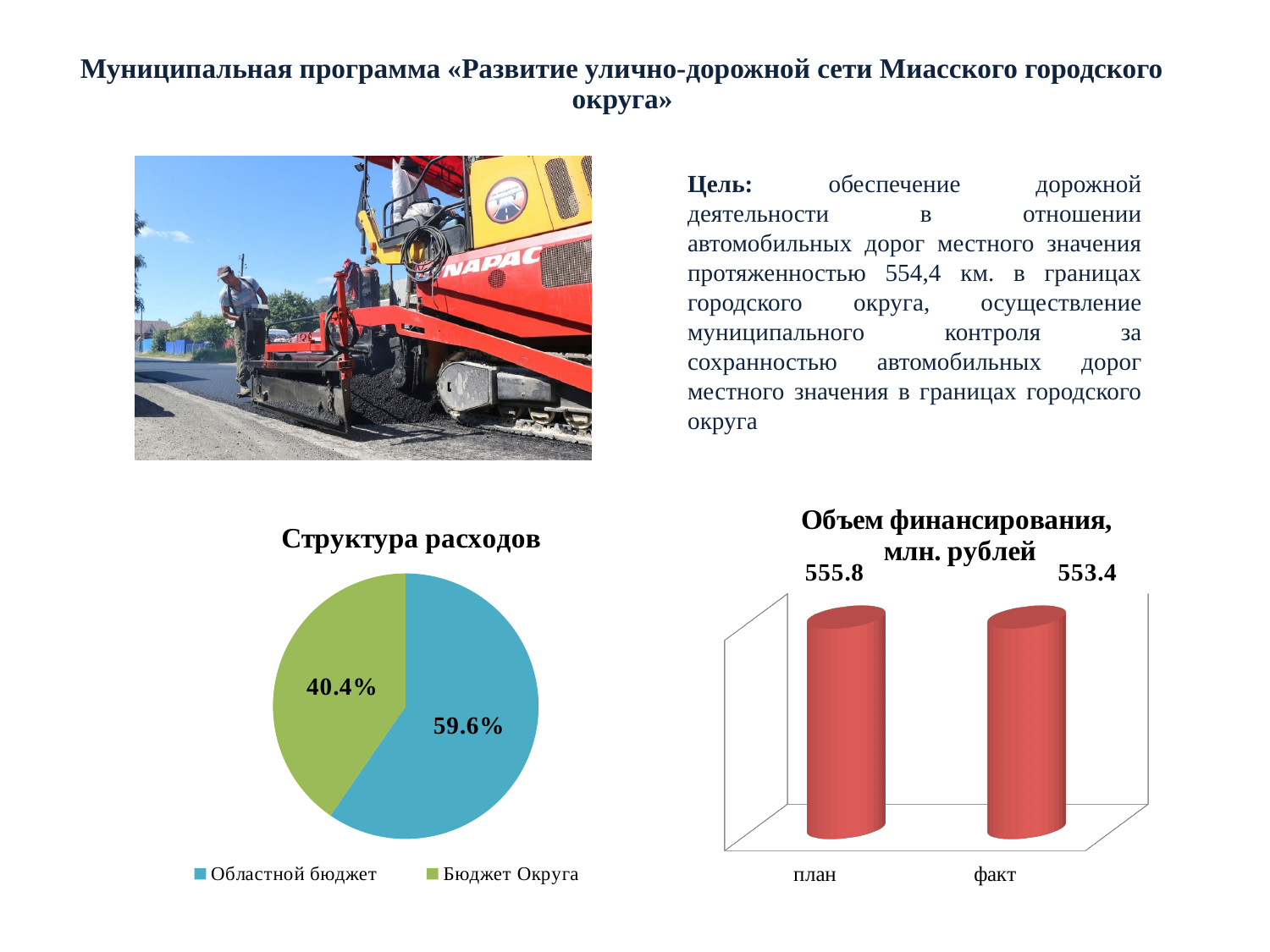
In the chart titled «Структура расходов», what is the difference in percentage points between «Областной бюджет» and «Бюджет Округа»? 19.2 In the chart titled «Объем финансирования, млн. рублей», what is the value for «план»? 555.8 How many entries does the legend of the chart titled «Структура расходов» list? 2 In the chart titled «Объем финансирования, млн. рублей», what is the difference between «план» and «факт»? 2.4 In the chart titled «Структура расходов», which slice is the largest? Областной бюджет In the chart titled «Структура расходов», what share does «Бюджет Округа» have? 40.4% How many categories are shown in the chart titled «Объем финансирования, млн. рублей»? 2 In the chart titled «Структура расходов», what share does «Областной бюджет» have? 59.6% What kind of chart is the one titled «Структура расходов»? Pie chart What kind of chart is the one titled «Объем финансирования, млн. рублей»? Bar chart In the chart titled «Объем финансирования, млн. рублей», what is the value for «факт»? 553.4 In the chart titled «Объем финансирования, млн. рублей», which is larger, «план» or «факт»? план